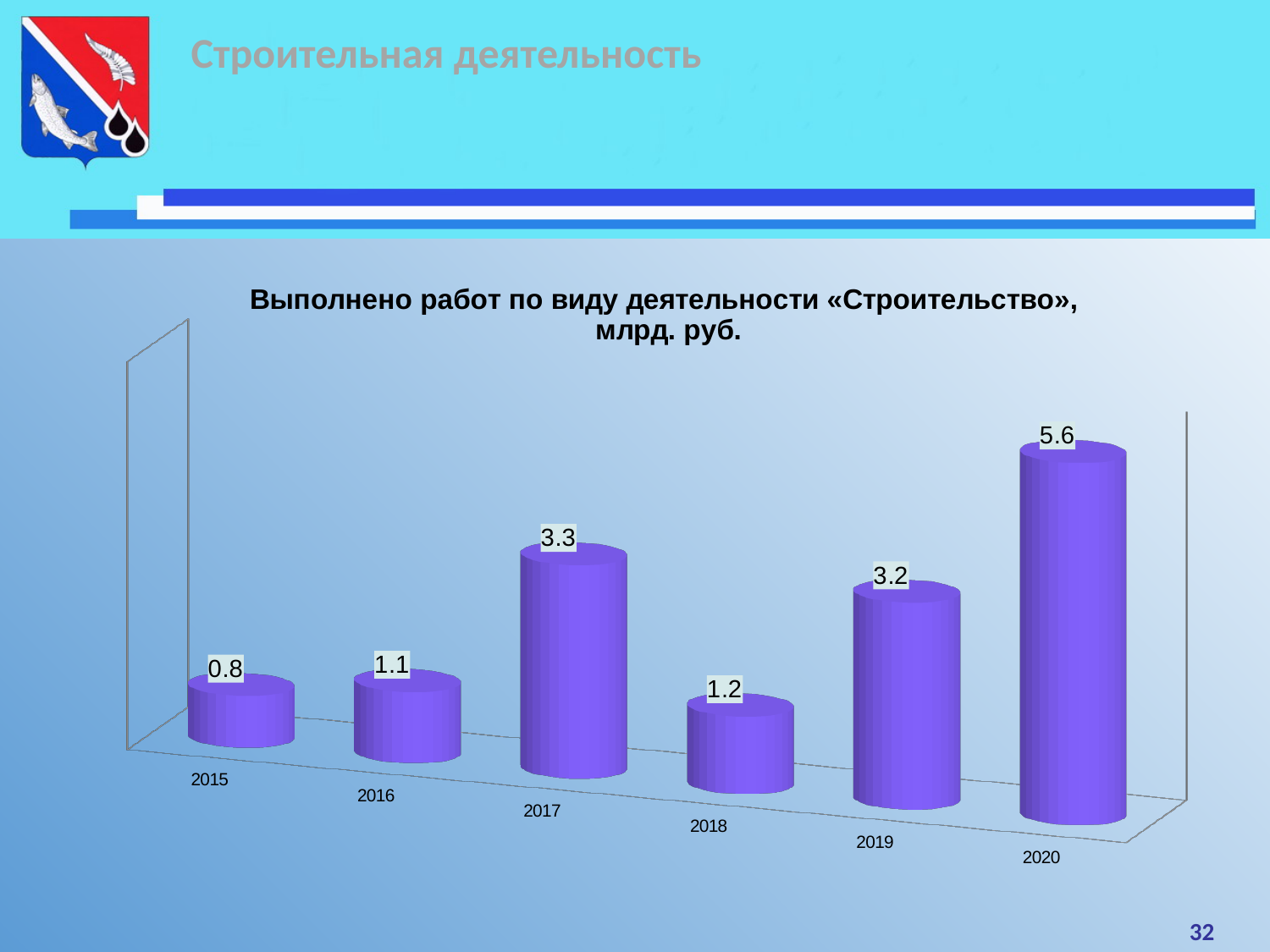
What is the value for 2017? 3.3 What is the value for 2015? 0.8 What is the difference between the values for 2020 and 2019? 2.4 What is the difference between the values for 2017 and 2018? 2.1 What kind of chart is this? bar chart Which year has the highest value? 2020 Which year has the lowest value? 2015 How many years are shown on the chart? 6 What is the value for 2020? 5.6 What unit is given in the chart title? млрд. руб. Which is larger, the value for 2016 or the value for 2018? 2018 Does the value rise or fall from 2018 to 2020? rise